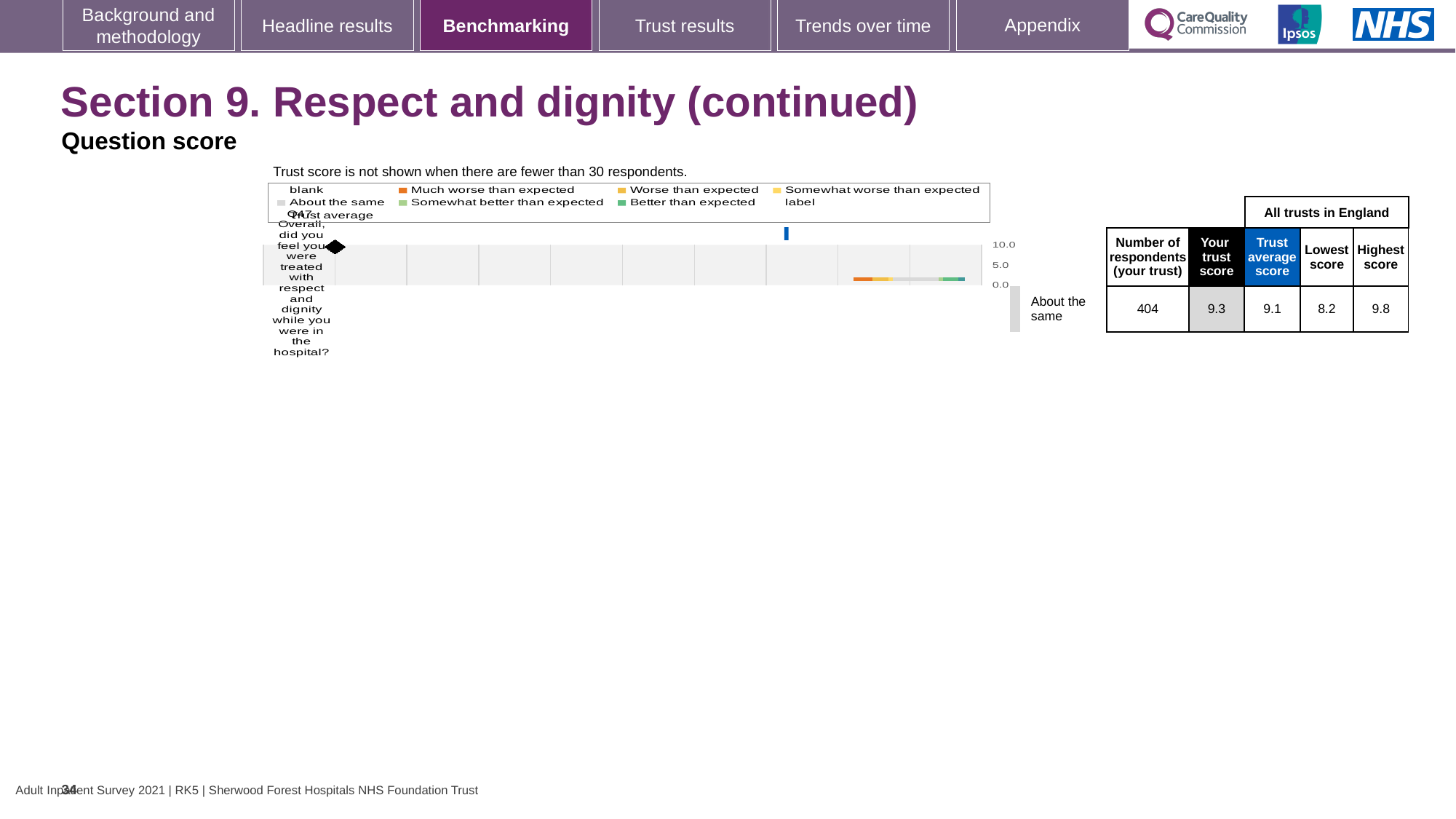
How many survey questions are plotted on the chart? 1 According to the table next to the chart, what is the trust average score for all trusts in England? 9.1 According to the table next to the chart, what is the lowest score among all trusts in England? 8.2 What is the difference between the highest score (9.8) and the lowest score (8.2) shown in the table? 1.6 According to the table next to the chart, what is the highest score among all trusts in England? 9.8 Is the trust's score of 9.3 greater or less than 5.0 on the chart's axis? greater What benchmark category is the trust's score placed in for this question? About the same Which legend entry is shown in orange on the chart? Much worse than expected According to the table next to the chart, how many respondents did the trust have for this question? 404 What is the highest value shown on the chart's vertical axis? 10.0 Is the trust's score (9.3) higher or lower than the trust average score (9.1) shown in the table? higher According to the table next to the chart, what is the trust's score for the question about being treated with respect and dignity? 9.3